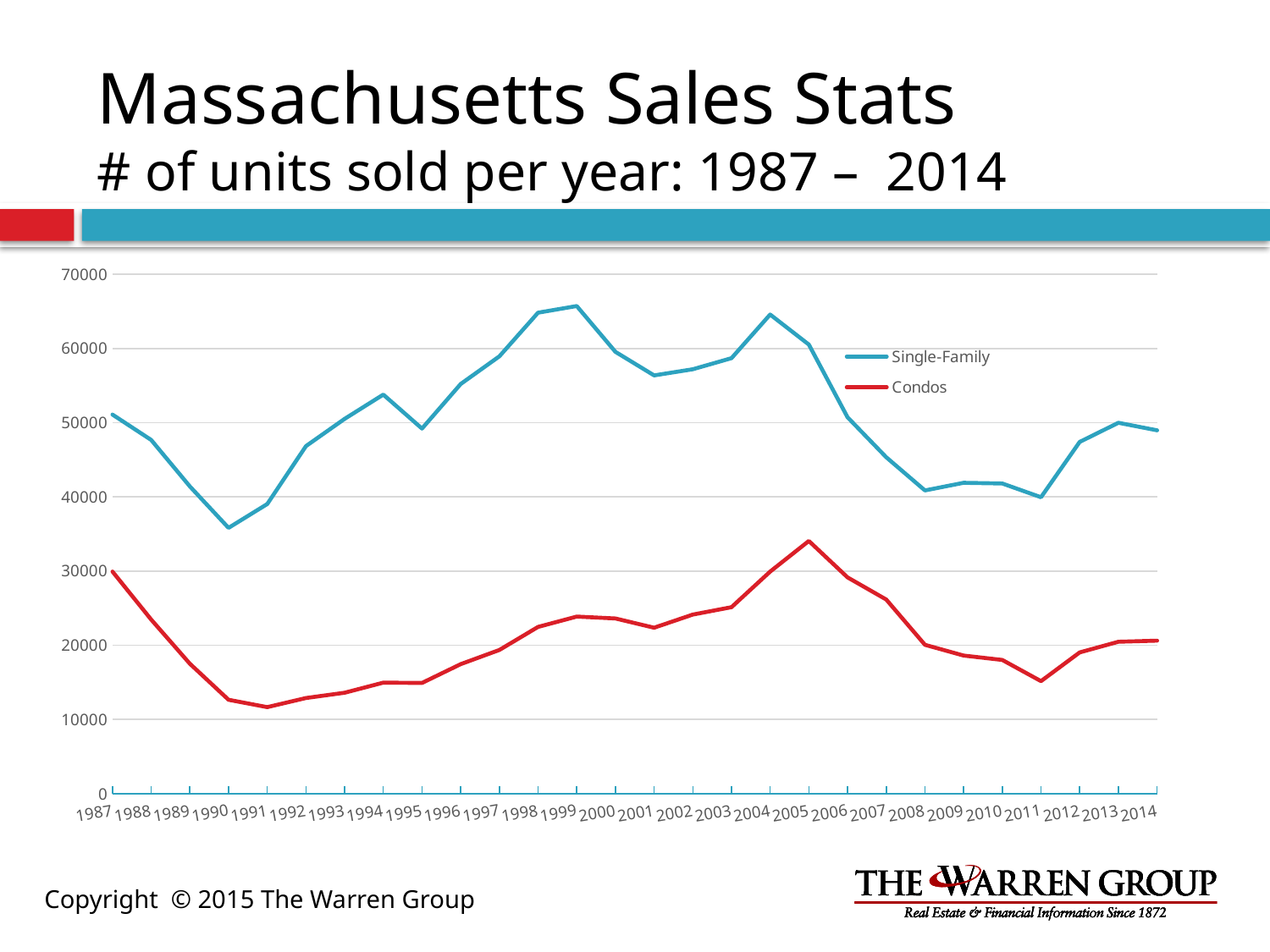
How many years are plotted along the x axis? 28 Is the Condos value for 1991 greater or less than 20000? less In which year does the Single-Family series reach its lowest value? 1990 In which year does the Condos series reach its lowest value? 1991 Is the Condos value for 2005 greater or less than 30000? greater Which series has the higher value in 2010, Single-Family or Condos? Single-Family In which year does the Condos series reach its highest value? 2005 Does the Single-Family series rise or fall from 2005 to 2011? fall In which year does the Single-Family series reach its highest value? 1999 What kind of chart is shown on the slide? line chart Is the Single-Family value for 1999 greater or less than 60000? greater How many series does the legend list? 2